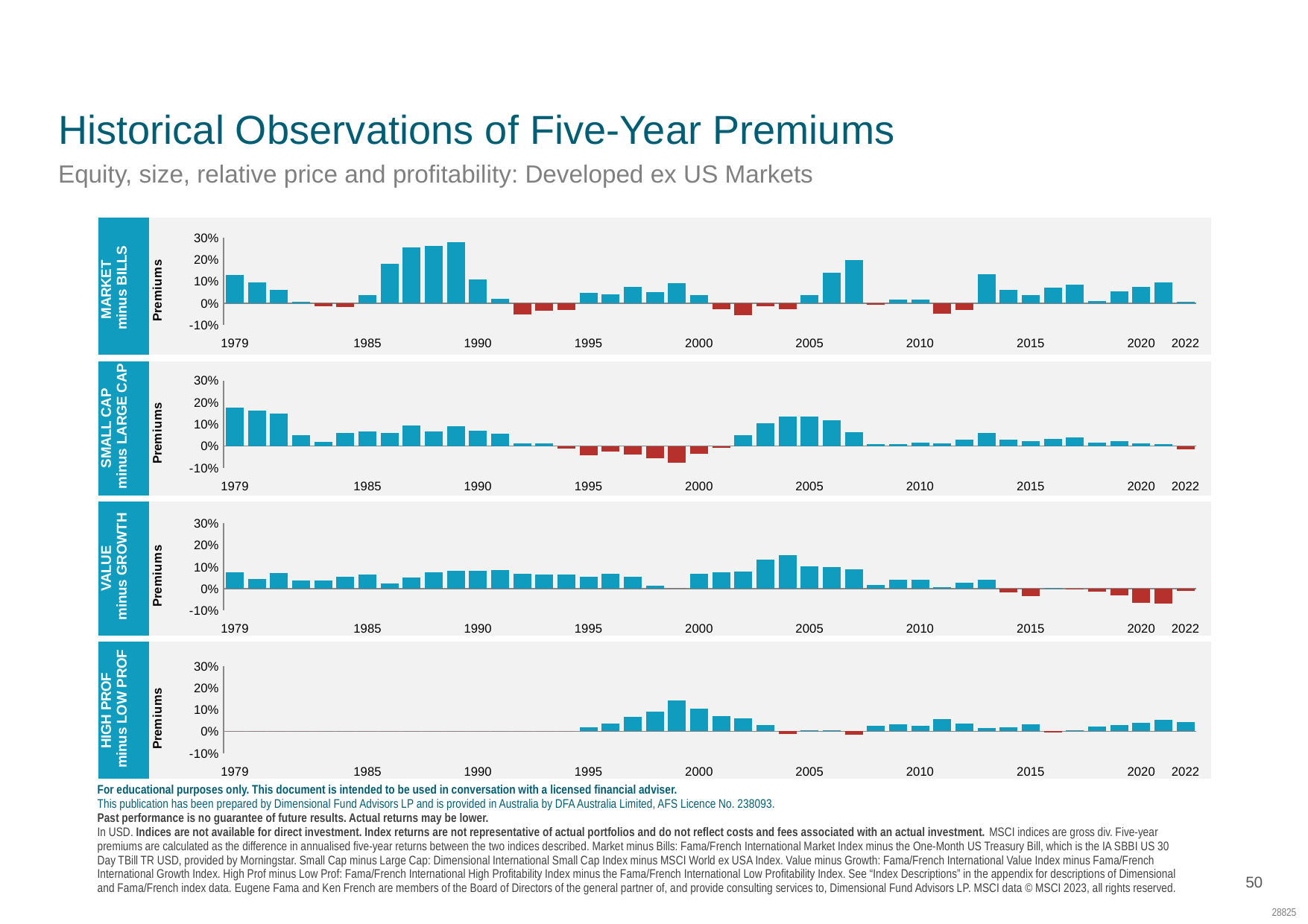
In the MARKET minus BILLS chart, which year has the larger value, 1979 or 2010? 1979 In the VALUE minus GROWTH chart, is the value for 2020 greater or less than 0%? less How many chart panels are shown on the slide? 4 In the SMALL CAP minus LARGE CAP chart, is the value for 2005 greater or less than 10%? greater In the HIGH PROF minus LOW PROF chart, is the value for 2010 greater or less than 10%? less What is the y-axis label on each chart panel? Premiums In the SMALL CAP minus LARGE CAP chart, which year has the larger value, 1979 or 2022? 1979 In the VALUE minus GROWTH chart, do the values rise or fall from 2005 to 2010? fall What kind of chart is used in the MARKET minus BILLS panel? bar chart What is the label of the top chart panel? MARKET minus BILLS